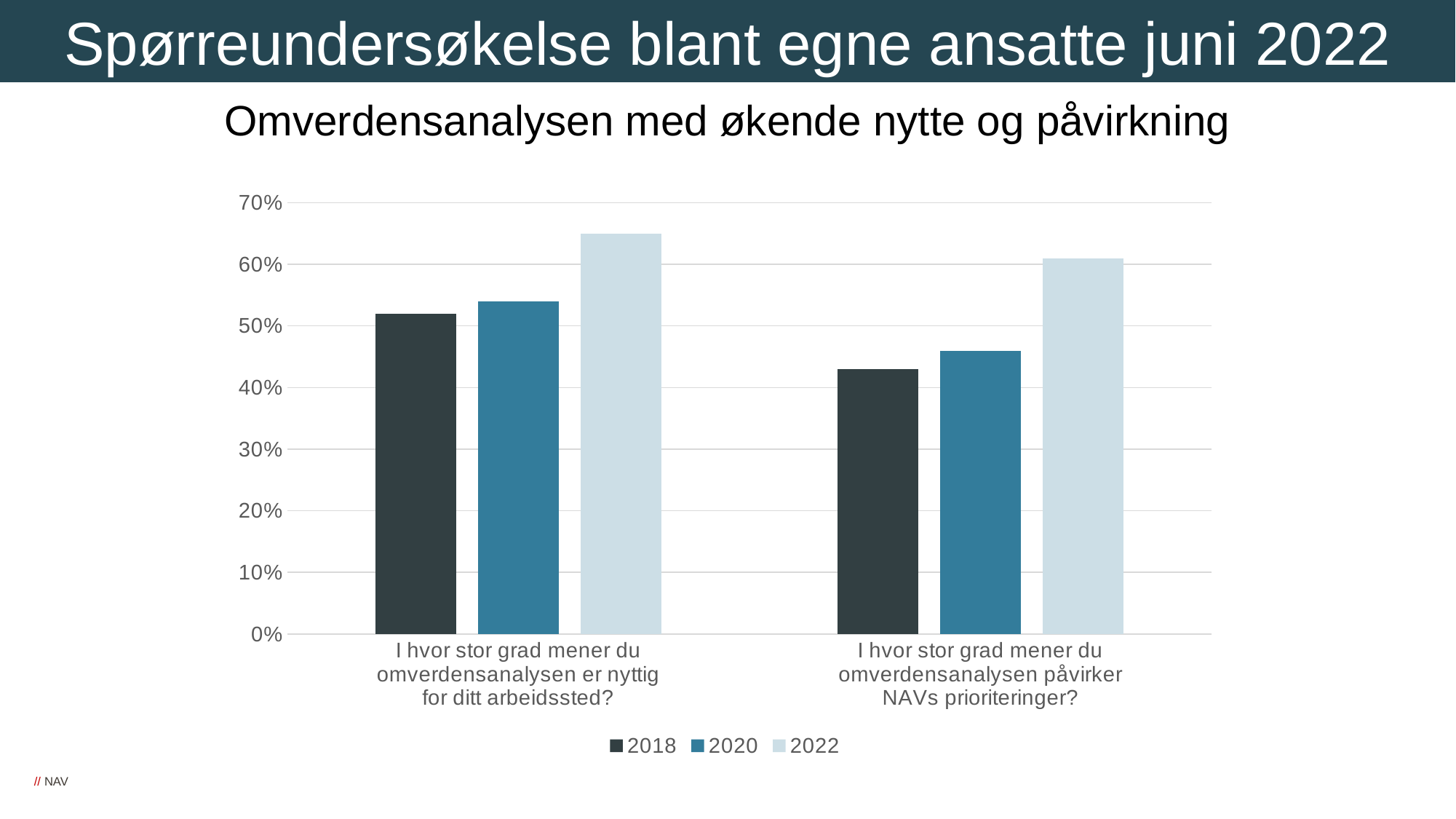
Which years are listed in the legend? 2018, 2020, 2022 Which year has the lowest value for 'I hvor stor grad mener du omverdensanalysen er nyttig for ditt arbeidssted?'? 2018 Is the 2020 value for 'I hvor stor grad mener du omverdensanalysen påvirker NAVs prioriteringer?' greater or less than 40%? greater Which year has the highest value for 'I hvor stor grad mener du omverdensanalysen påvirker NAVs prioriteringer?'? 2022 For 2022, which question has the larger value: the one about usefulness for the workplace or the one about influencing NAV's priorities? usefulness for the workplace How many series does the legend list? 3 How many question categories are shown on the x axis? 2 Do the values for 'I hvor stor grad mener du omverdensanalysen påvirker NAVs prioriteringer?' rise or fall from 2018 to 2022? rise Is the 2018 value for 'I hvor stor grad mener du omverdensanalysen påvirker NAVs prioriteringer?' greater or less than 50%? less Is the 2022 value for 'I hvor stor grad mener du omverdensanalysen er nyttig for ditt arbeidssted?' greater or less than 60%? greater What kind of chart is shown on the slide? bar chart